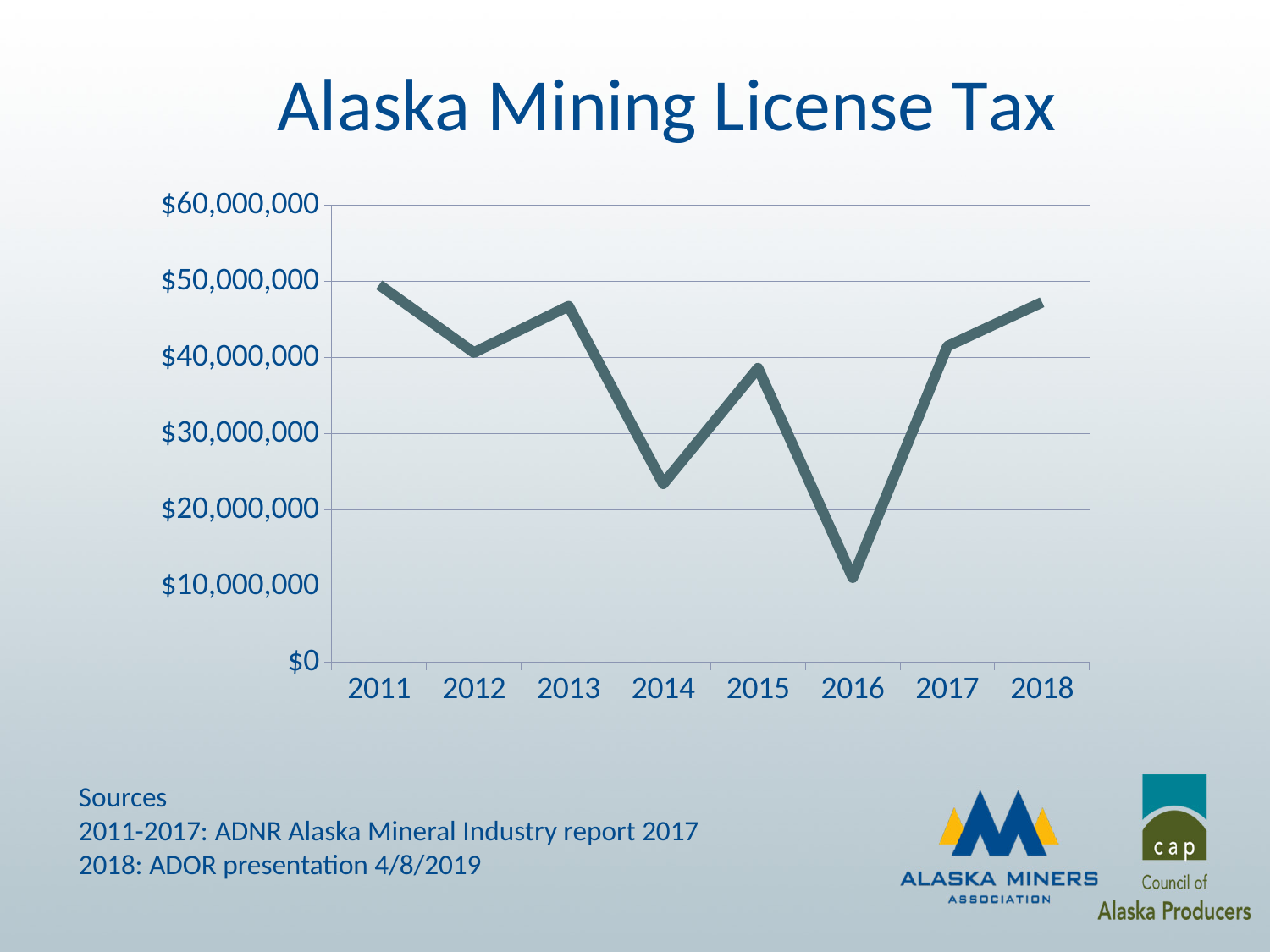
Is the value for 2014 greater or less than $30,000,000? less Is the value for 2018 greater or less than $40,000,000? greater Which year has the highest value? 2011 What is the title of the chart? Alaska Mining License Tax Which is larger, the value for 2016 or the value for 2017? 2017 How many years are plotted on the x axis? 8 Which is larger, the value for 2014 or the value for 2015? 2015 Is the value for 2013 greater or less than $50,000,000? less Which year has the lowest value? 2016 What kind of chart is shown on the slide? line chart Do the values rise or fall from 2016 to 2018? rise